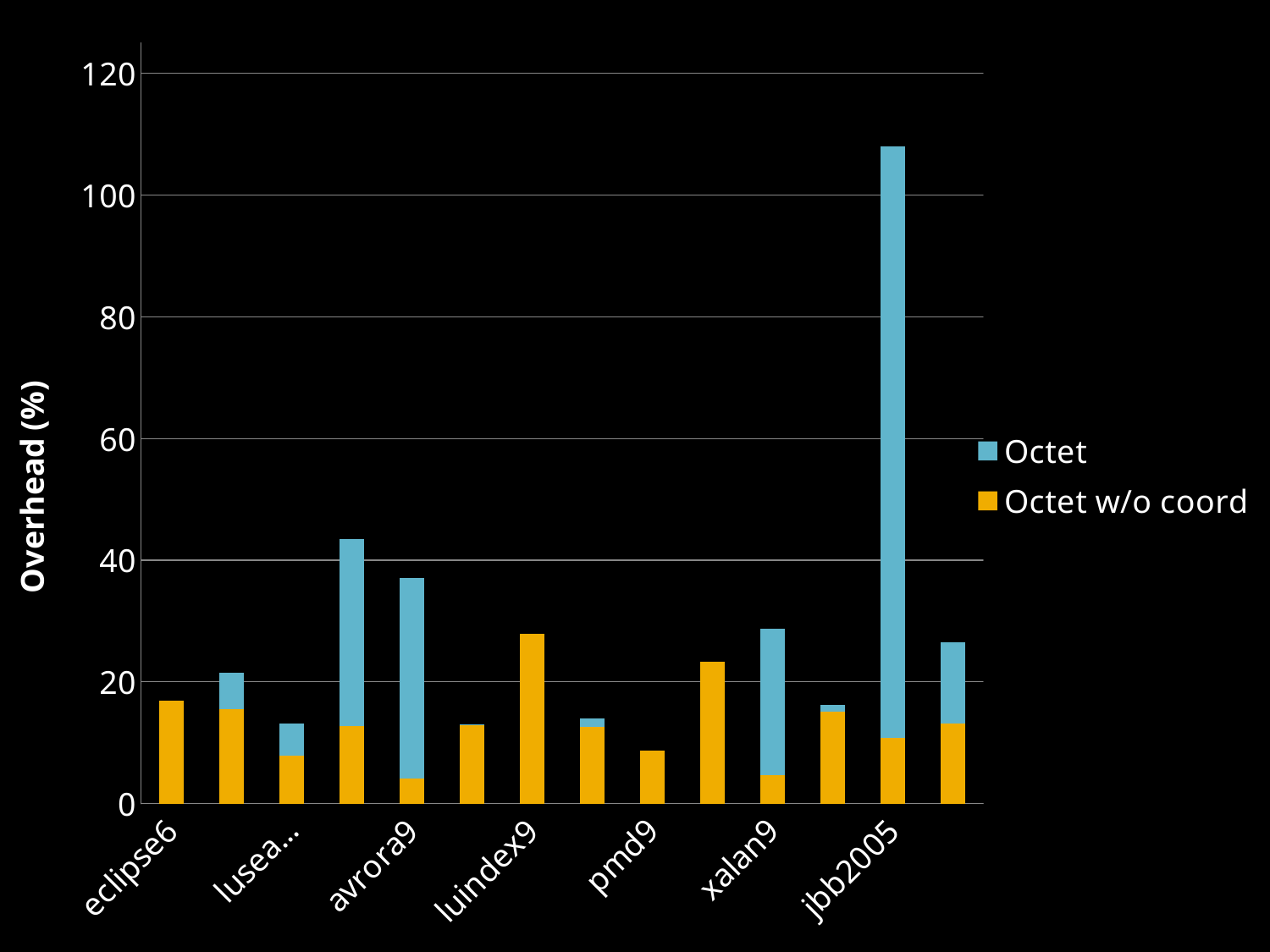
Which has the taller bar, luindex9 or pmd9? luindex9 Is the overhead for eclipse6 greater or less than 20? less How many bars are plotted in the chart? 14 What kind of chart is shown on the slide? bar chart Is the total overhead for jbb2005 greater or less than 100? greater Is the overhead for pmd9 greater or less than 20? less What is the title of the vertical axis? Overhead (%) Which labeled category has the tallest bar? jbb2005 Which has the taller bar, jbb2005 or avrora9? jbb2005 What are the two series named in the legend? Octet and Octet w/o coord How many series does the legend list? 2